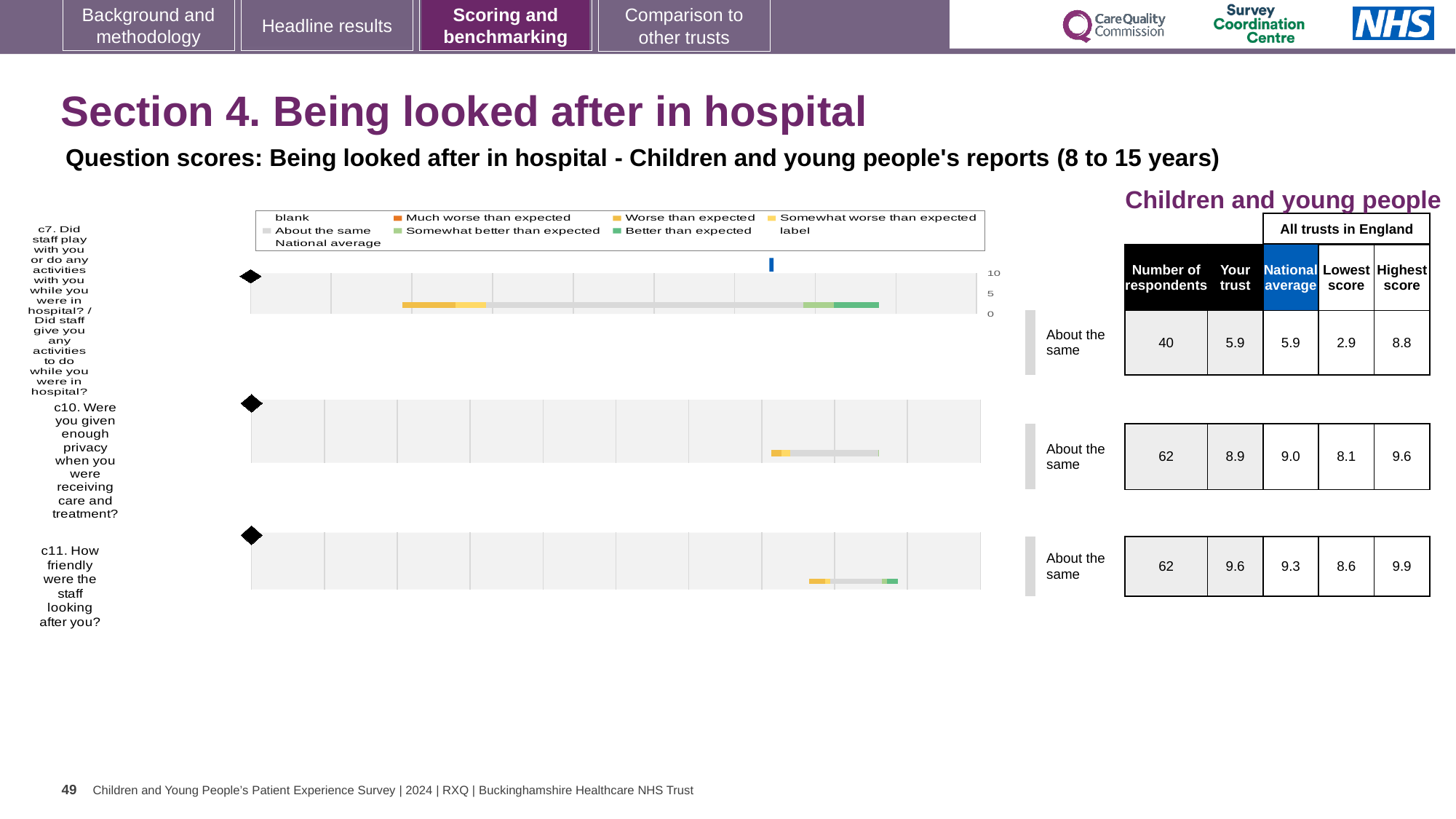
How many questions (chart rows) are plotted on the slide? 3 What kind of chart is used to show the question scores on this slide? bar chart For c11, what is the difference between the highest score and the lowest score across all trusts in England? 1.3 What is the 'Your trust' score for c11 (How friendly were the staff looking after you?)? 9.6 How many respondents answered question c7? 40 Is the 'Your trust' score for c7 greater or less than 5? greater Which question has the highest 'Your trust' score? c11 What is the national average score for c10 (Were you given enough privacy when you were receiving care and treatment?)? 9.0 What benchmark category is shown for all three questions on the slide? About the same What is the lowest score across all trusts in England for c7? 2.9 Which question has the lowest 'Your trust' score? c7 For c10, which is larger: the 'Your trust' score or the national average? National average